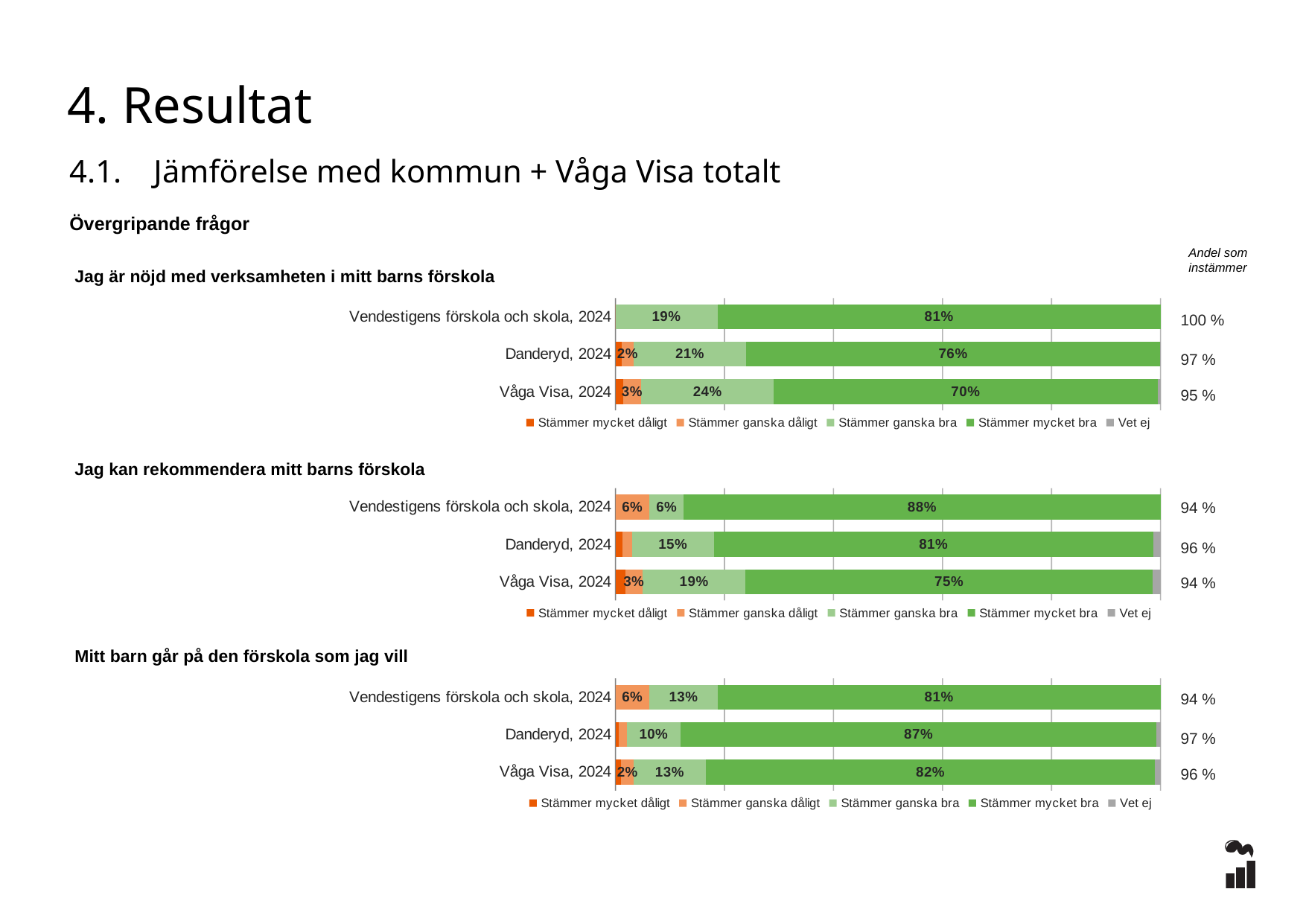
In the chart 'Jag är nöjd med verksamheten i mitt barns förskola', what is the difference between the 'Stämmer mycket bra' values for Danderyd, 2024 and Våga Visa, 2024? 6% In the chart 'Jag kan rekommendera mitt barns förskola', which row has the lowest 'Stämmer mycket bra' value? Våga Visa, 2024 In the chart 'Jag kan rekommendera mitt barns förskola', what is the 'Andel som instämmer' value for Danderyd, 2024? 96 % In the chart 'Mitt barn går på den förskola som jag vill', how many rows (categories) are shown? 3 In the chart 'Jag är nöjd med verksamheten i mitt barns förskola', what is the 'Stämmer mycket bra' value for Vendestigens förskola och skola, 2024? 81% In the chart 'Mitt barn går på den förskola som jag vill', what is the 'Stämmer mycket bra' value for Danderyd, 2024? 87% In the chart 'Jag är nöjd med verksamheten i mitt barns förskola', what is the 'Stämmer ganska bra' value for Våga Visa, 2024? 24% How many series does the legend of the chart 'Jag kan rekommendera mitt barns förskola' list? 5 In the chart 'Jag kan rekommendera mitt barns förskola', what is the 'Stämmer mycket bra' value for Vendestigens förskola och skola, 2024? 88% What kind of chart is 'Jag är nöjd med verksamheten i mitt barns förskola'? Stacked bar chart In the chart 'Mitt barn går på den förskola som jag vill', which is larger: the 'Stämmer ganska bra' value for Vendestigens förskola och skola, 2024 or for Danderyd, 2024? Vendestigens förskola och skola, 2024 In the chart 'Jag är nöjd med verksamheten i mitt barns förskola', which row has the highest 'Stämmer mycket bra' value? Vendestigens förskola och skola, 2024